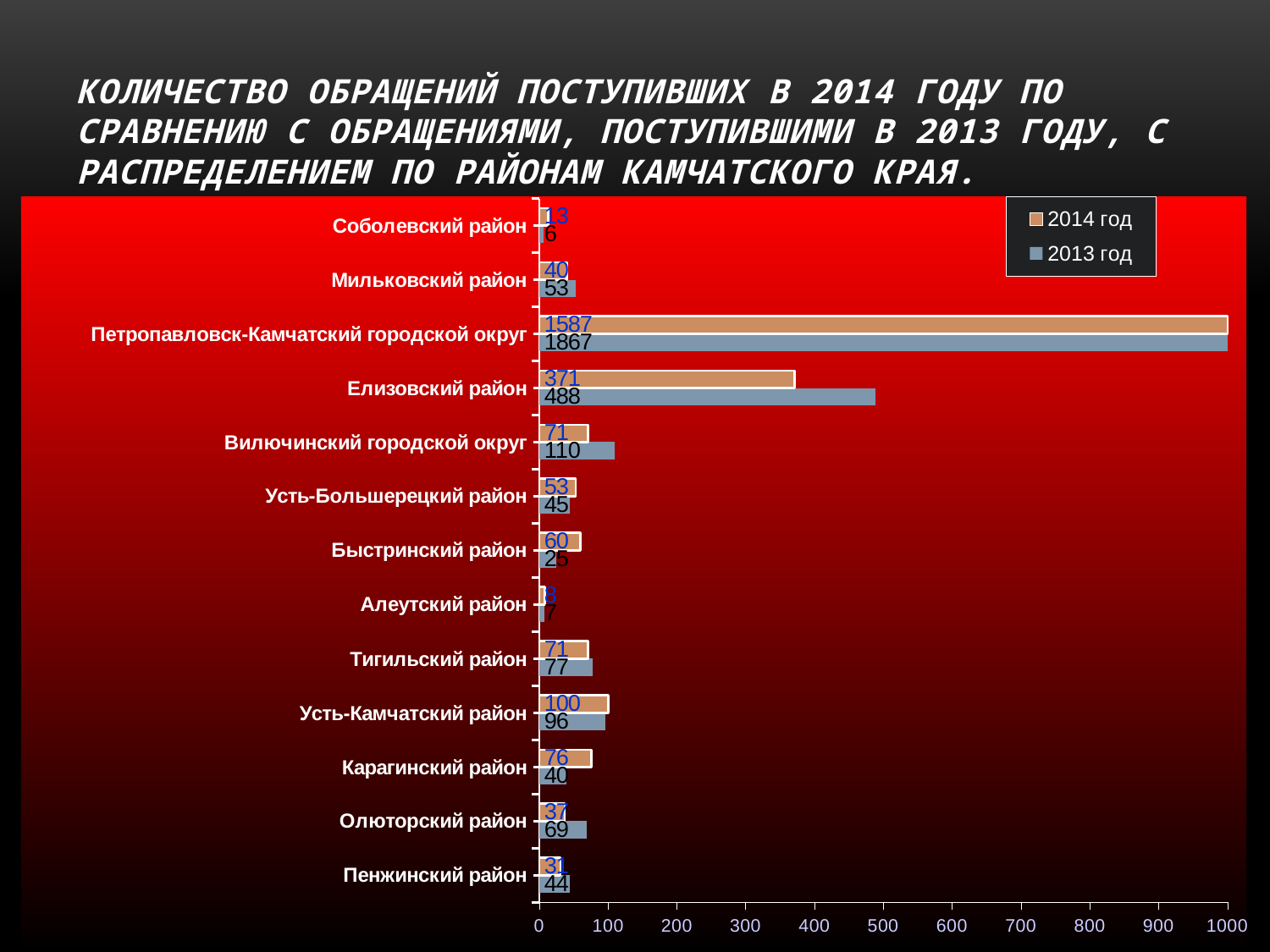
Which district has the highest value in the 2014 год series? Петропавловск-Камчатский городской округ What is the value for Петропавловск-Камчатский городской округ in the 2014 год series? 1587 What is the difference between the 2013 год and 2014 год values for Петропавловск-Камчатский городской округ? 280 What type of chart is shown on the slide? bar chart What is the value for Елизовский район in the 2013 год series? 488 Which series is shown in orange in the legend? 2014 год How many series does the legend list? 2 Which district has the lowest value in the 2013 год series? Соболевский район Is the 2013 год value for Елизовский район greater or less than 400? greater What is the value for Вилючинский городской округ in the 2013 год series? 110 Which is larger for Карагинский район: the 2014 год value or the 2013 год value? 2014 год How many districts (categories) are shown on the chart? 13